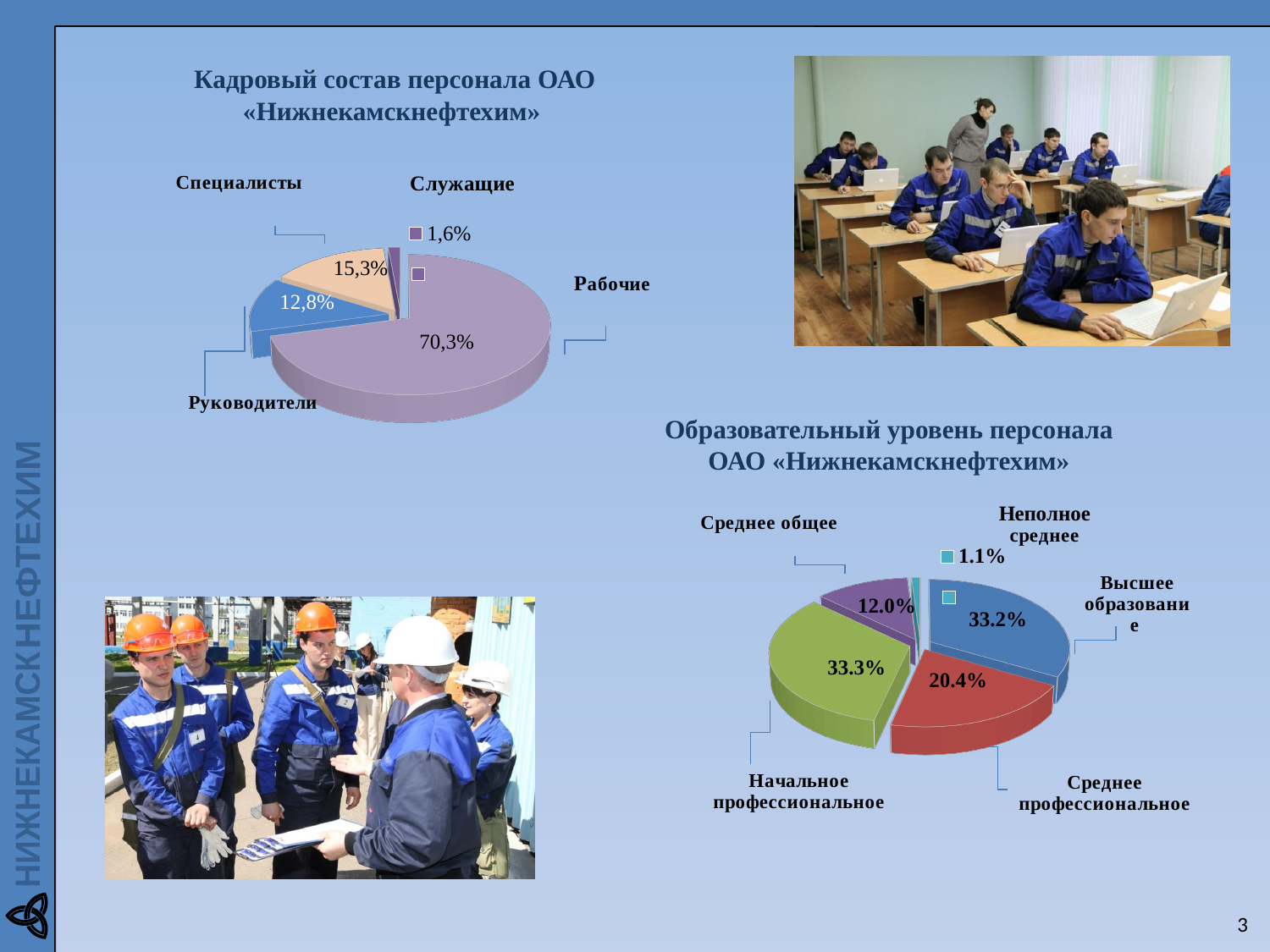
In the chart titled «Кадровый состав персонала ОАО «Нижнекамскнефтехим»», which category has the largest share? Рабочие In the chart titled «Образовательный уровень персонала ОАО «Нижнекамскнефтехим»», how many categories are shown? 5 In the chart titled «Образовательный уровень персонала ОАО «Нижнекамскнефтехим»», which category has the smallest share? Неполное среднее In the chart titled «Кадровый состав персонала ОАО «Нижнекамскнефтехим»», which category has the smallest share? Служащие In the chart titled «Кадровый состав персонала ОАО «Нижнекамскнефтехим»», what share is shown for Специалисты? 15,3% What type of chart is the one titled «Кадровый состав персонала ОАО «Нижнекамскнефтехим»»? Pie chart In the chart titled «Кадровый состав персонала ОАО «Нижнекамскнефтехим»», how many categories are shown? 4 In the chart titled «Образовательный уровень персонала ОАО «Нижнекамскнефтехим»», what share is shown for Среднее общее? 12.0% In the chart titled «Образовательный уровень персонала ОАО «Нижнекамскнефтехим»», which is larger: Высшее образование or Среднее профессиональное? Высшее образование In the chart titled «Образовательный уровень персонала ОАО «Нижнекамскнефтехим»», what share is shown for Среднее профессиональное? 20.4% In the chart titled «Кадровый состав персонала ОАО «Нижнекамскнефтехим»», what is the difference between the shares of Специалисты and Руководители? 2,5% In the chart titled «Кадровый состав персонала ОАО «Нижнекамскнефтехим»», what share is shown for Рабочие? 70,3%